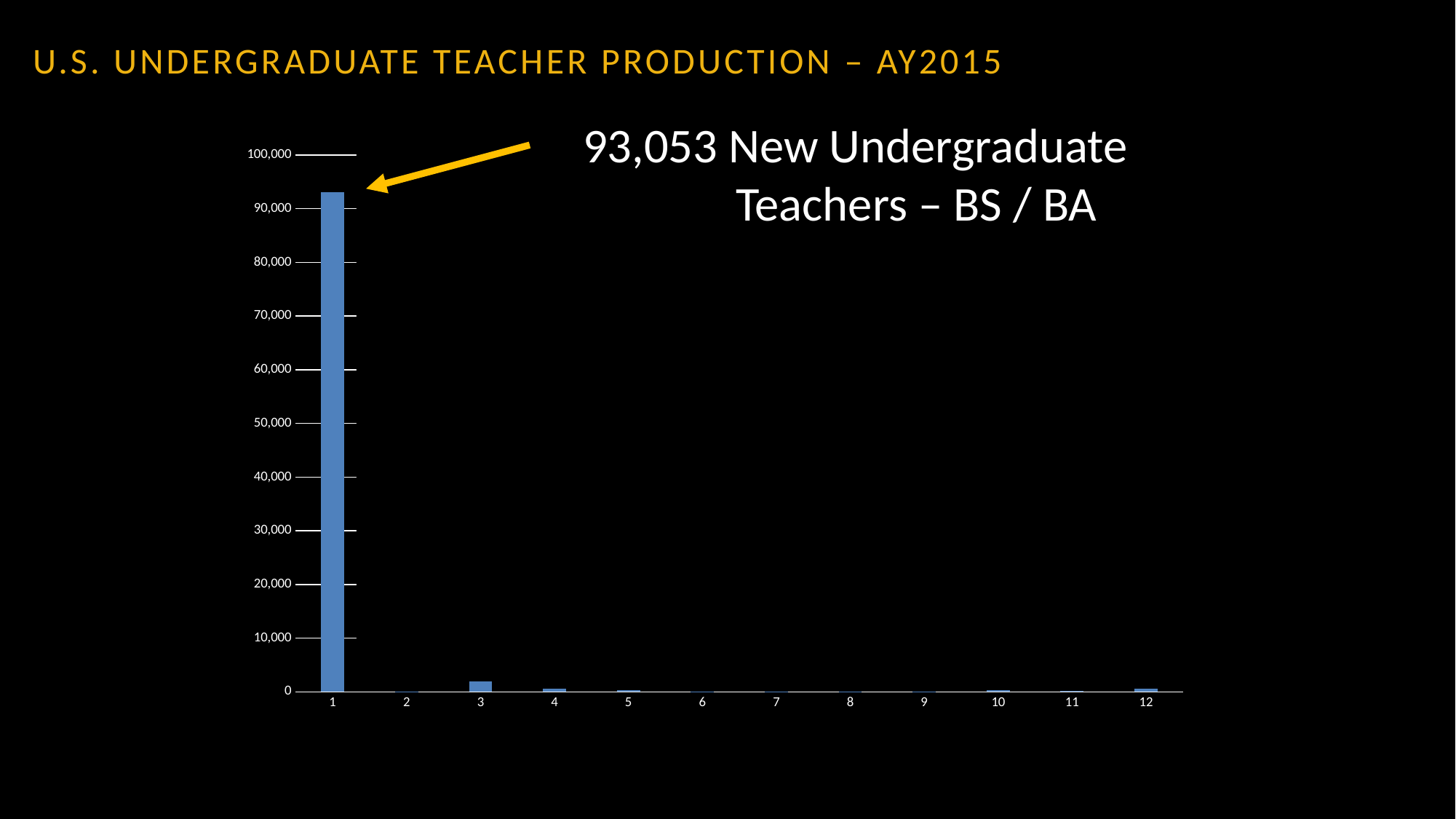
Which is larger, the value for category 1 or the value for category 3? category 1 Is the value for category 12 greater or less than 10,000? less Which category has the highest value? 1 What kind of chart is shown on the slide? bar chart Is the value for category 1 greater or less than 90,000? greater How many categories are plotted along the x axis? 12 What is the title of the slide containing the chart? U.S. Undergraduate Teacher Production – AY2015 Which is larger, the value for category 3 or the value for category 4? category 3 What is the highest tick value shown on the y axis? 100,000 Is the value for category 3 greater or less than 10,000? less What value does the annotation give for the bar at category 1? 93,053